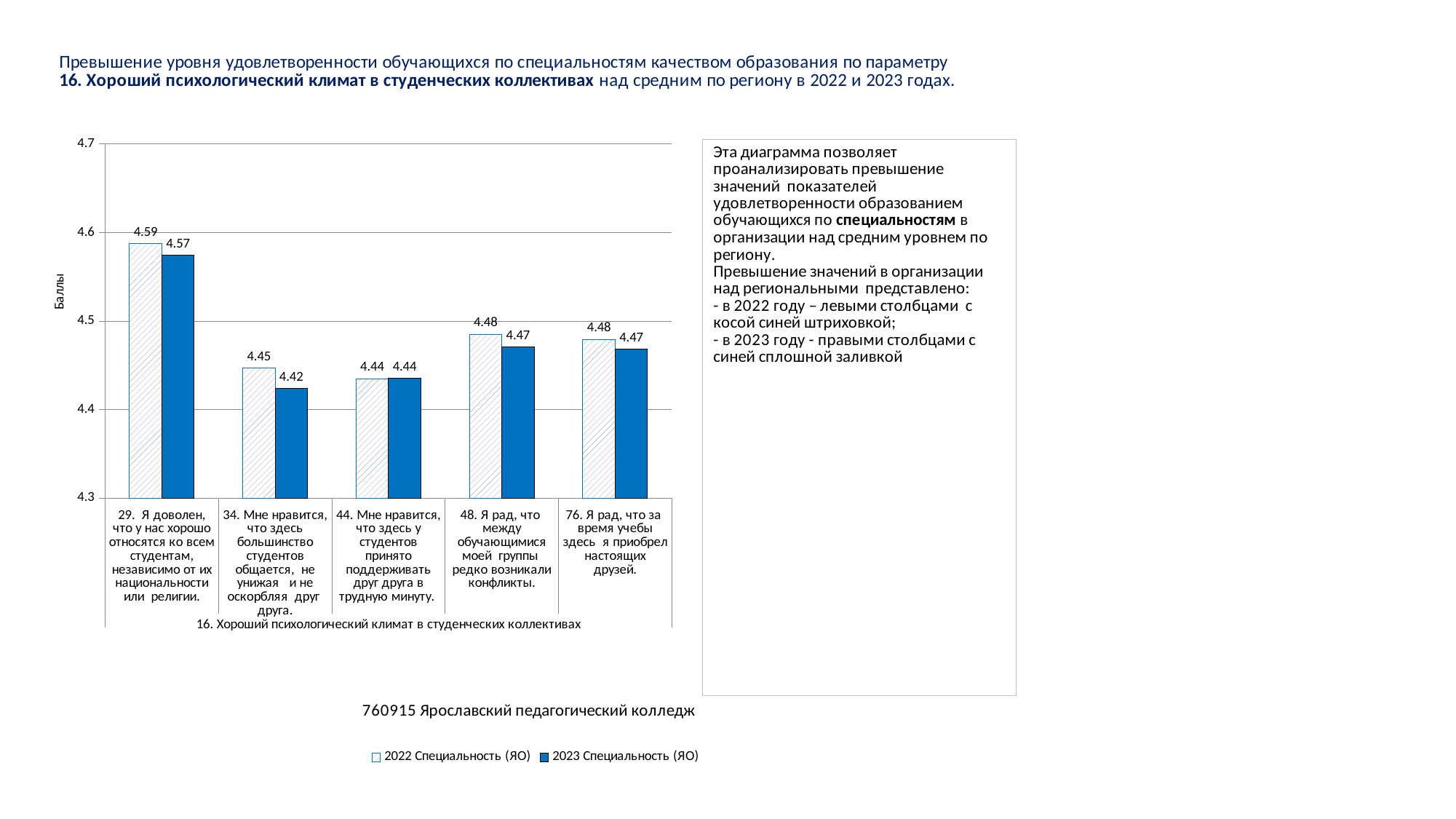
Is the 2023 Специальность (ЯО) value for category 29 greater or less than 4.5? greater How many categories are shown on the x axis of the chart? 5 What is the 2023 Специальность (ЯО) value for category 34 (Мне нравится, что здесь большинство студентов общается, не унижая и не оскорбляя друг друга)? 4.42 How many series does the chart legend list? 2 What is the difference between the 2022 and 2023 Специальность (ЯО) values for category 34? 0.03 Which category has the lowest 2023 Специальность (ЯО) value? 34. Мне нравится, что здесь большинство студентов общается, не унижая и не оскорбляя друг друга. What type of chart is shown on the slide? bar chart Which category has the highest 2022 Специальность (ЯО) value? 29. Я доволен, что у нас хорошо относятся ко всем студентам, независимо от их национальности или религии. For category 29, which is larger: the 2022 Специальность (ЯО) value or the 2023 Специальность (ЯО) value? 2022 Специальность (ЯО) What is the label of the vertical axis of the chart? Баллы What is the 2022 Специальность (ЯО) value for category 29 (Я доволен, что у нас хорошо относятся ко всем студентам...)? 4.59 What is the 2023 Специальность (ЯО) value for category 44 (Мне нравится, что здесь у студентов принято поддерживать друг друга в трудную минуту)? 4.44